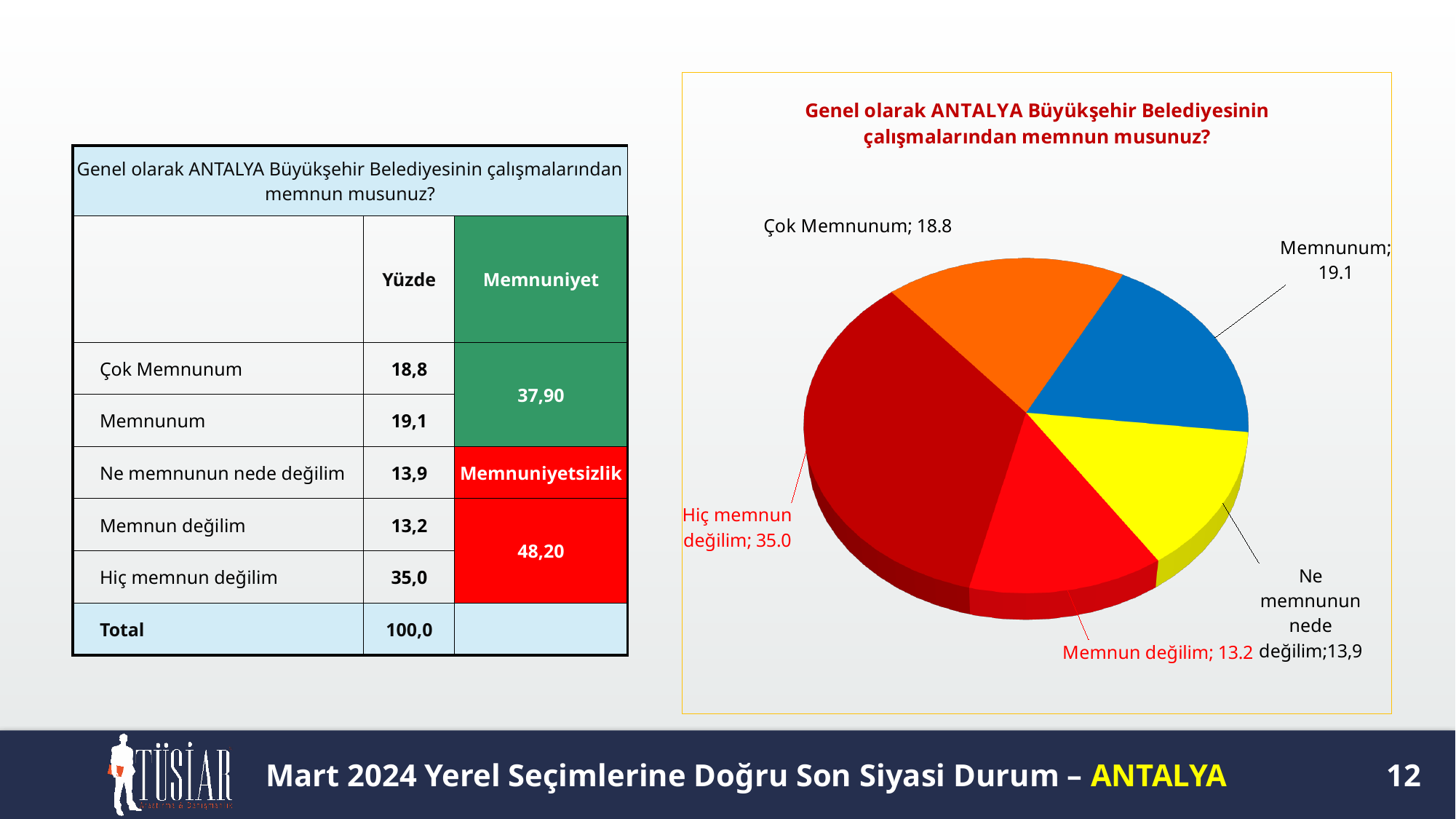
What is the value for Çok Memnunum in the pie chart? 18.8 What is the value for Memnunum in the pie chart? 19.1 What is the value for Ne memnunun nede değilim in the pie chart? 13,9 What is the title of the pie chart? Genel olarak ANTALYA Büyükşehir Belediyesinin çalışmalarından memnun musunuz? What kind of chart is shown on the slide? pie chart What is the value for Memnun değilim in the pie chart? 13.2 Which category has the smallest slice in the pie chart? Memnun değilim Which category has the largest slice in the pie chart? Hiç memnun değilim What is the difference between the values for Hiç memnun değilim and Memnun değilim in the pie chart? 21.8 How many slices does the pie chart have? 5 What is the value for Hiç memnun değilim in the pie chart? 35.0 Which is larger in the pie chart, Memnunum or Çok Memnunum? Memnunum